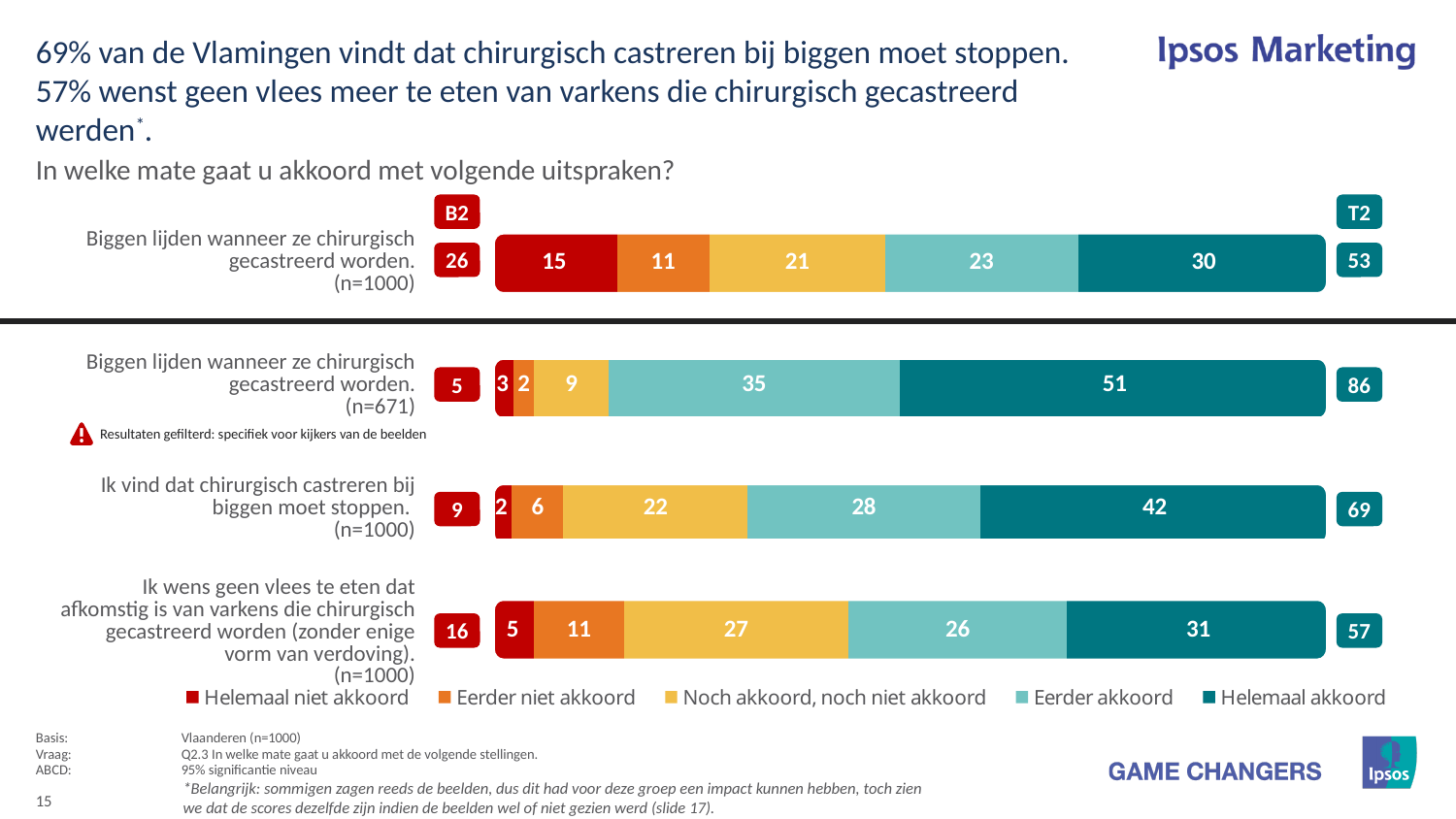
Which is larger: the 'Eerder akkoord' value for 'Biggen lijden wanneer ze chirurgisch gecastreerd worden' (n=1000) or for 'Ik vind dat chirurgisch castreren bij biggen moet stoppen'? Ik vind dat chirurgisch castreren bij biggen moet stoppen What is the 'Noch akkoord, noch niet akkoord' value for 'Ik wens geen vlees te eten dat afkomstig is van varkens die chirurgisch gecastreerd worden'? 27 What is the 'Helemaal akkoord' value for 'Biggen lijden wanneer ze chirurgisch gecastreerd worden' (n=1000)? 30 Which legend entry is shown in dark red? Helemaal niet akkoord What is the T2 value for 'Ik vind dat chirurgisch castreren bij biggen moet stoppen'? 69 Which statement has the lowest B2 value? Biggen lijden wanneer ze chirurgisch gecastreerd worden (n=671) How many statements (bars) are plotted in the chart? 4 Which statement has the highest T2 value? Biggen lijden wanneer ze chirurgisch gecastreerd worden (n=671) What kind of chart is shown on the slide? Stacked bar chart What is the 'Helemaal akkoord' value for 'Biggen lijden wanneer ze chirurgisch gecastreerd worden' (n=671)? 51 What is the difference between the 'Helemaal akkoord' values for 'Ik vind dat chirurgisch castreren bij biggen moet stoppen' and 'Ik wens geen vlees te eten dat afkomstig is van varkens die chirurgisch gecastreerd worden'? 11 How many series does the legend list? 5